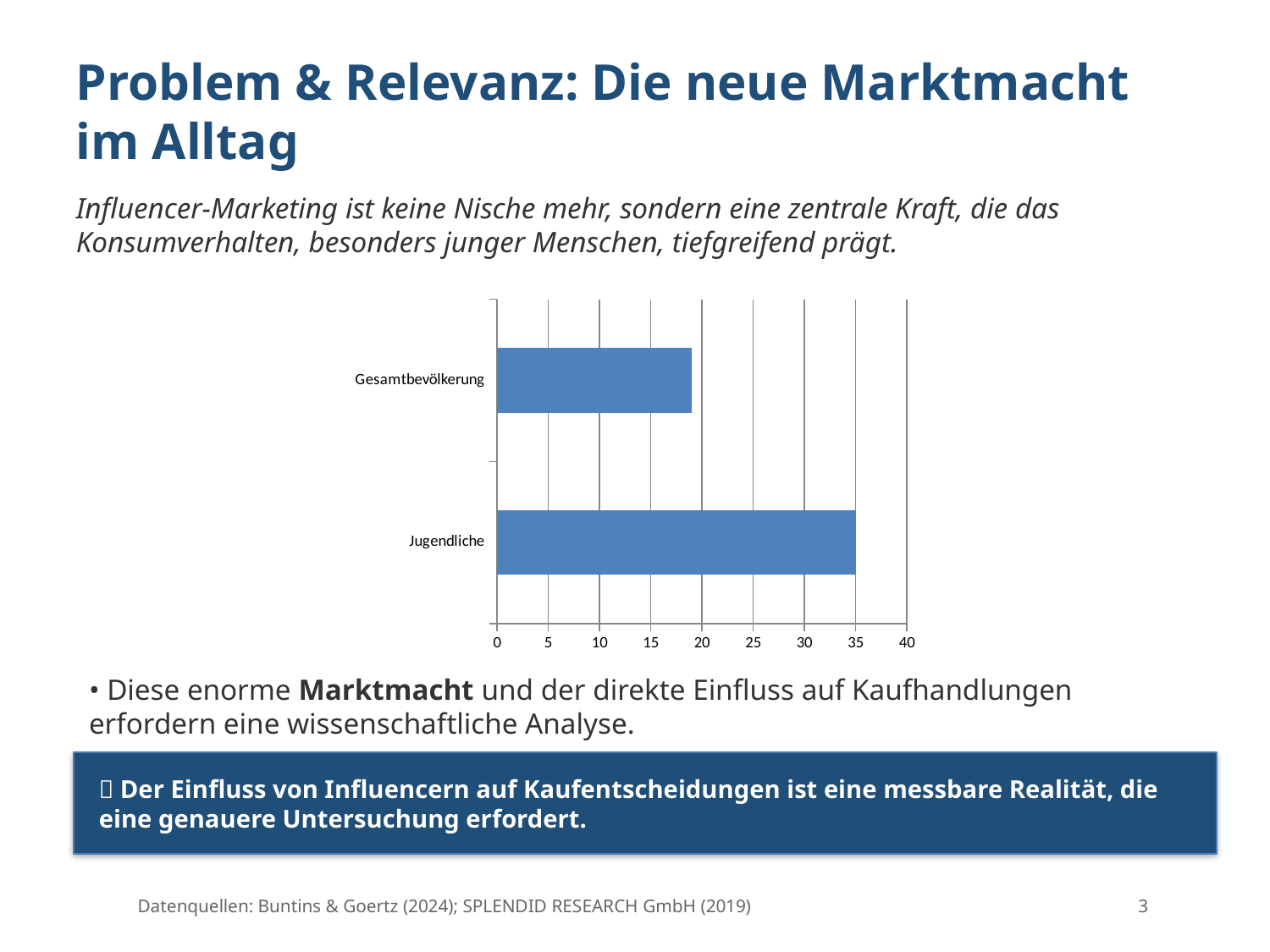
Is the value for Gesamtbevölkerung greater or less than 20? less How many categories does the chart show? 2 Which is larger, the value for Jugendliche or the value for Gesamtbevölkerung? Jugendliche What is the highest value shown on the chart's value axis? 40 What kind of chart is shown on the slide? bar chart Which category has the lowest value in the chart? Gesamtbevölkerung Is the value for Gesamtbevölkerung greater or less than 15? greater Which category has the highest value in the chart? Jugendliche Is the value for Jugendliche greater or less than 30? greater Are the bars in the chart horizontal or vertical? horizontal What is the value for Jugendliche? 35